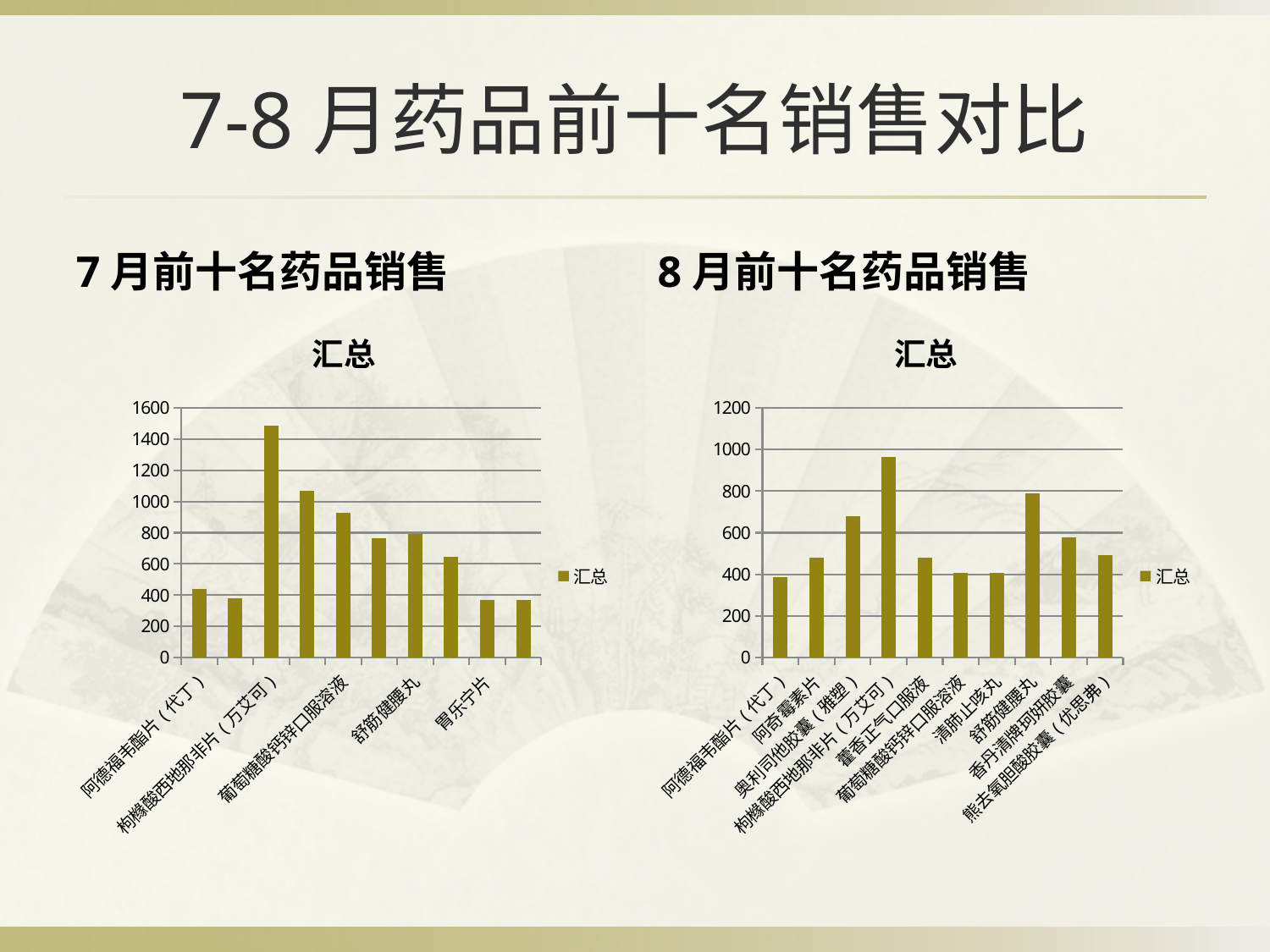
In the 8月前十名药品销售 chart on the right, which drug has the highest sales? 枸橼酸西地那非片（万艾可） In the 7月前十名药品销售 chart on the left, is the value for 胃乐宁片 greater or less than 400? less In the 7月前十名药品销售 chart on the left, which drug has the highest sales? 枸橼酸西地那非片（万艾可） In the 7月前十名药品销售 chart on the left, which has higher sales: 葡萄糖酸钙锌口服溶液 or 枸橼酸西地那非片（万艾可）? 枸橼酸西地那非片（万艾可） How many bars are plotted in the 8月前十名药品销售 chart on the right? 10 What is the legend entry shown in the 8月前十名药品销售 chart on the right? 汇总 What kind of chart is the 7月前十名药品销售 chart on the left? bar chart In the 8月前十名药品销售 chart on the right, is the value for 舒筋健腰丸 greater or less than 600? greater How many series does the legend of the 7月前十名药品销售 chart on the left list? 1 In the 8月前十名药品销售 chart on the right, which has higher sales: 奥利司他胶囊（雅塑） or 阿奇霉素片? 奥利司他胶囊（雅塑） In the 7月前十名药品销售 chart on the left, is the value for 枸橼酸西地那非片（万艾可） greater or less than 1400? greater